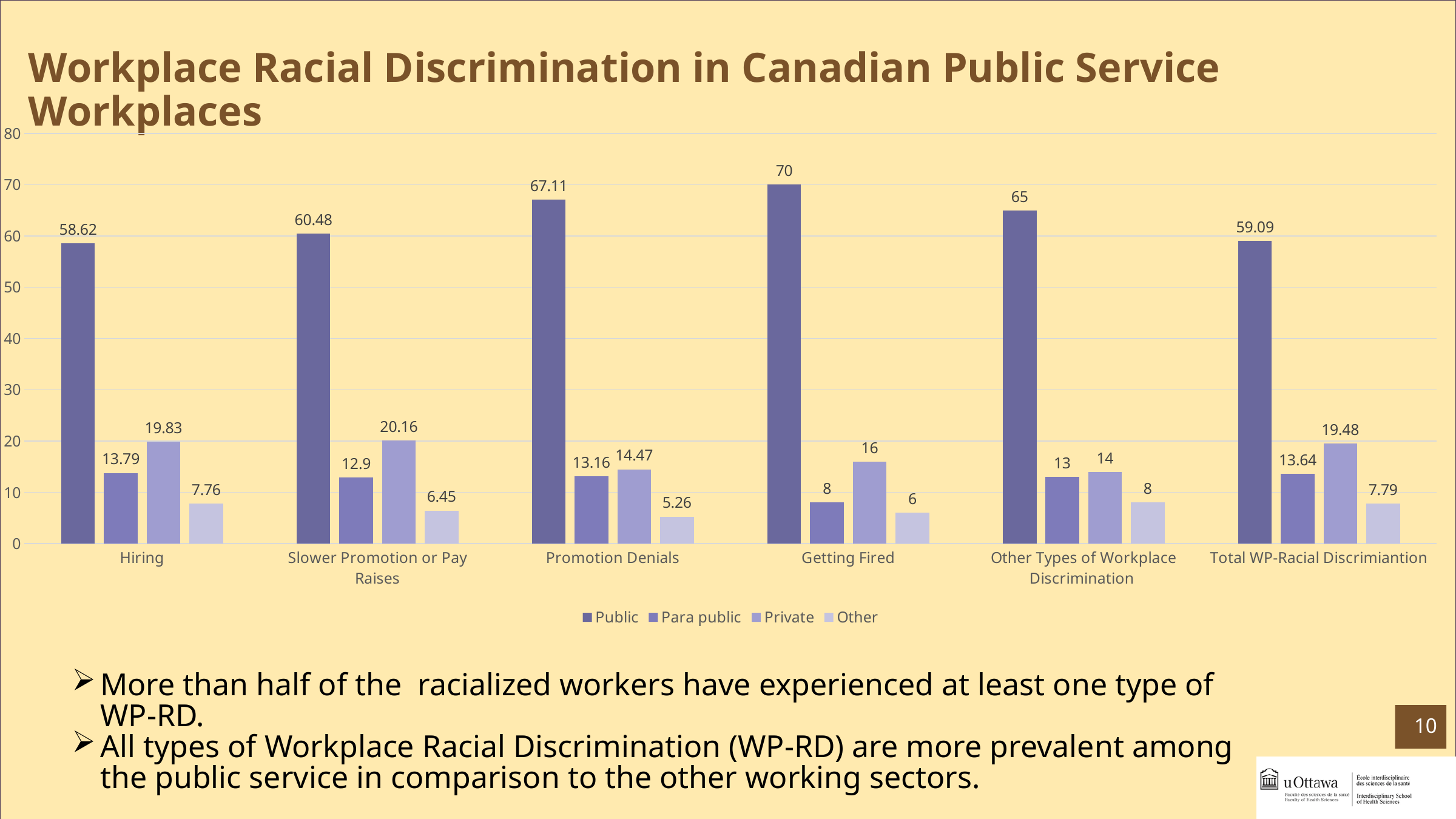
What is the Private value for Slower Promotion or Pay Raises? 20.16 Which category has the highest Public value? Getting Fired How many series does the legend list? 4 How many categories are shown on the x axis? 6 What kind of chart is shown on the slide? Bar chart Which category has the lowest Other value? Promotion Denials What is the difference between the Public and Private values for Hiring? 38.79 What are the series names listed in the legend? Public, Para public, Private, Other What is the Other value for Getting Fired? 6 What is the Public value for Promotion Denials? 67.11 Which is larger for Getting Fired: the Para public value or the Private value? Private What is the Para public value for Total WP-Racial Discrimiantion? 13.64